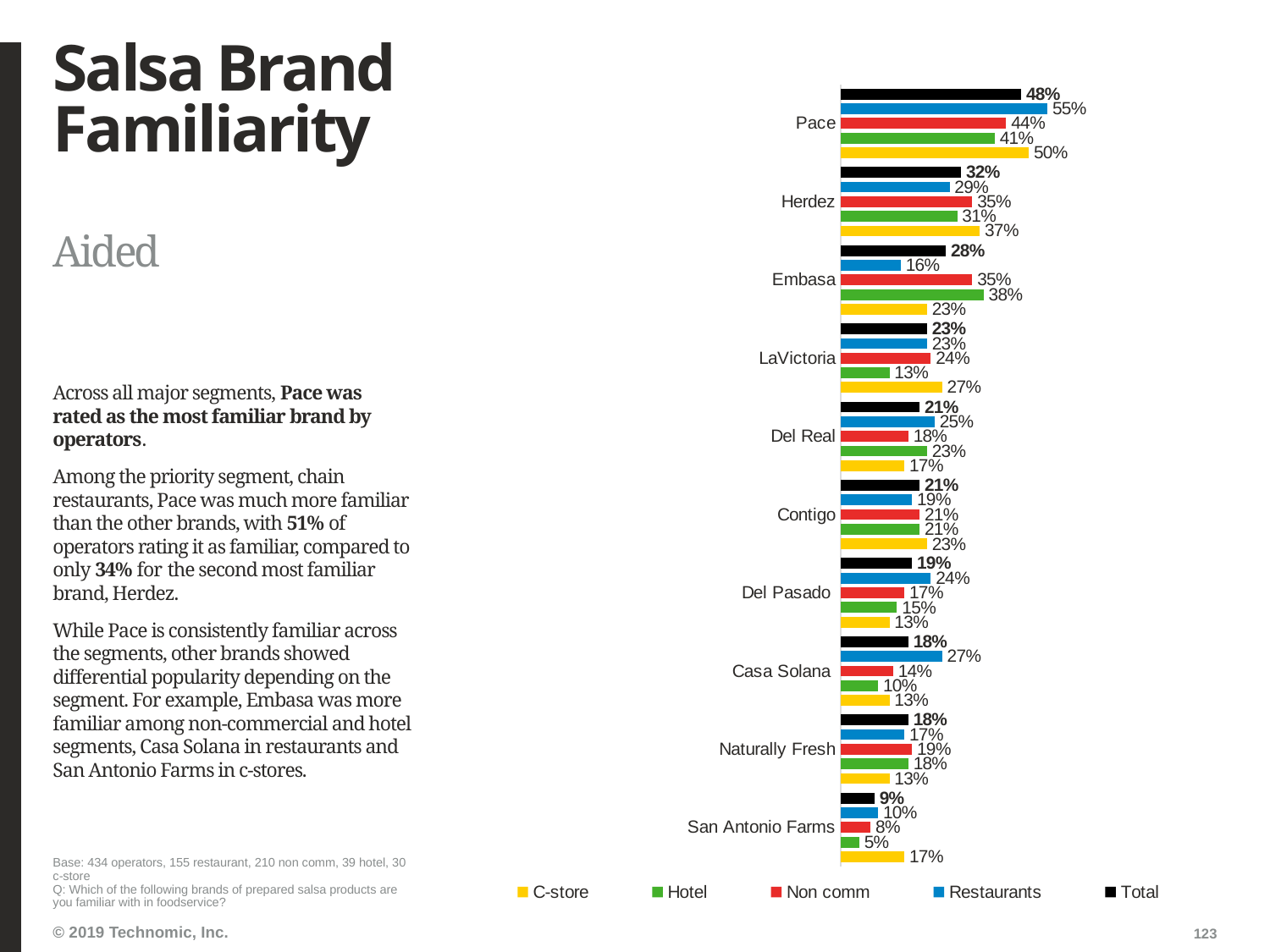
For Embasa, which is larger: the Non comm value or the Restaurants value? Non comm What is the Restaurants value for Casa Solana? 27% Which brand has the lowest Total familiarity? San Antonio Farms How many series does the legend list? 5 What is the Hotel value for Embasa? 38% What is the C-store value for San Antonio Farms? 17% What kind of chart is shown on the slide? Bar chart How many brands are shown in the chart? 10 Which brand has the highest Total familiarity? Pace What is the difference between the Restaurants value and the Hotel value for Pace? 14% Which colour represents the Total series in the chart? Black What is the Total familiarity value for Pace? 48%